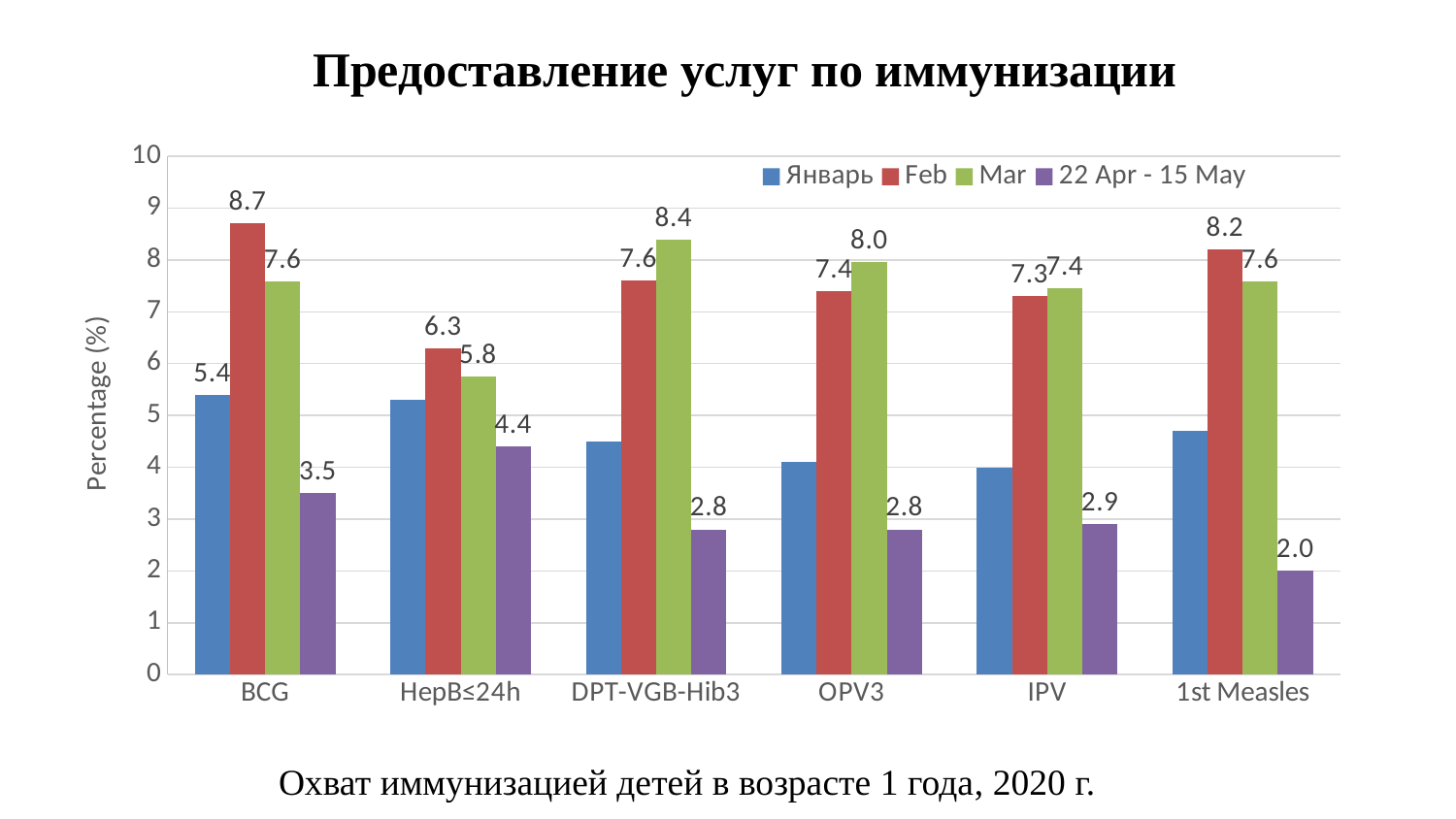
What is the label of the y axis? Percentage (%) What is the difference between the Feb and Mar values for BCG? 1.1 What is the 22 Apr - 15 May value for 1st Measles? 2.0 How many series does the legend list? 4 How many categories are shown on the x axis? 6 What kind of chart is shown on the slide? bar chart What is the Mar value for DPT-VGB-Hib3? 8.4 Which category has the lowest 22 Apr - 15 May value? 1st Measles Is the Январь value for IPV greater or less than 5? less Which category has the highest Feb value? BCG What is the Feb value for BCG? 8.7 For OPV3, which is larger: the Feb value or the Mar value? Mar